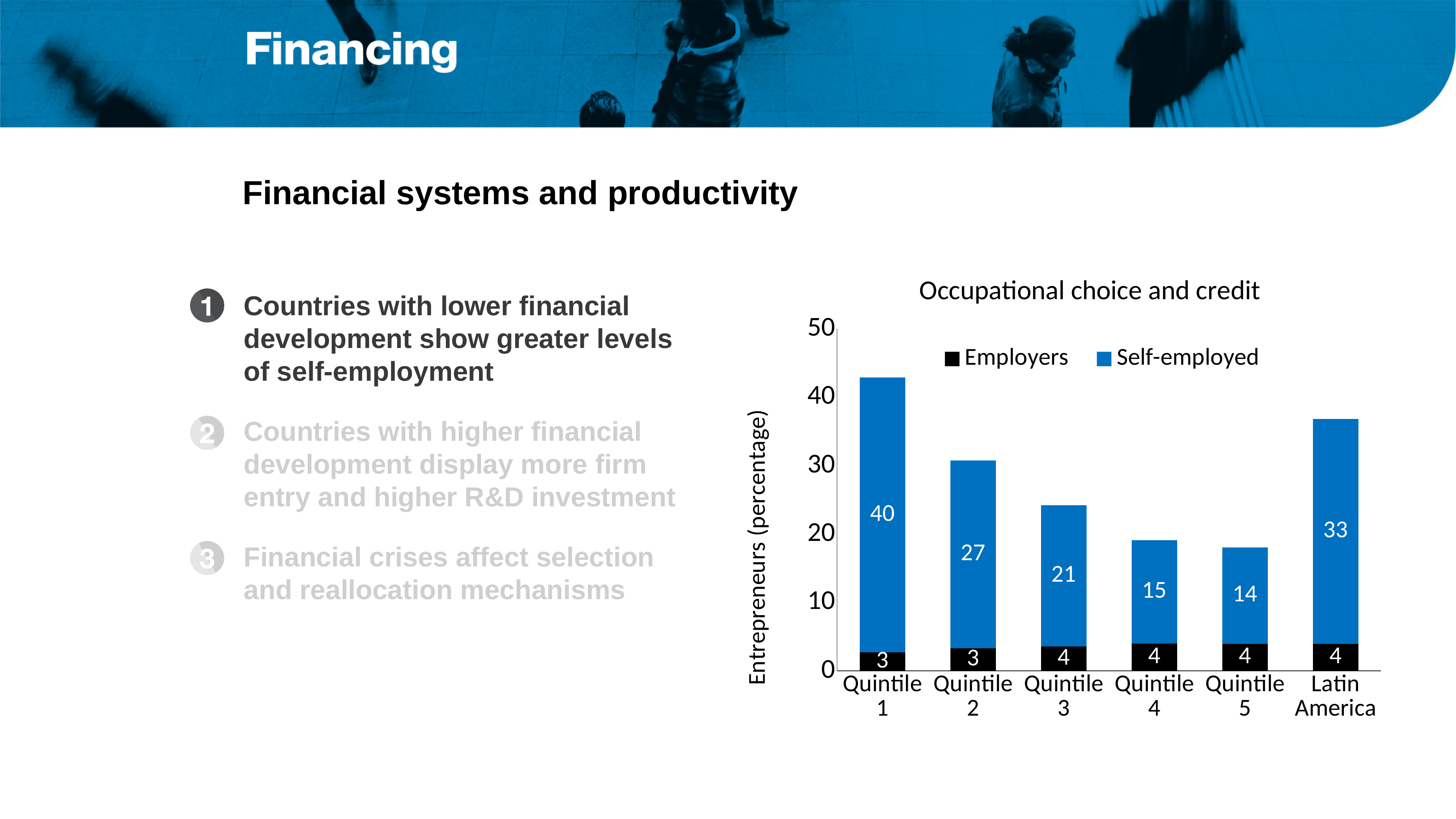
Which is larger, the Self-employed value for Quintile 3 or for Latin America? Latin America What kind of chart is shown? Stacked bar chart What is the total of the stacked bar for Quintile 1? 43 How many series does the legend list? 2 What is the Employers value for Latin America? 4 How many categories are shown on the x axis? 6 What is the difference between the Self-employed values for Quintile 1 and Quintile 2? 13 What is the Self-employed value for Quintile 4? 15 Which category has the highest Self-employed value? Quintile 1 What is the Self-employed value for Quintile 1? 40 Which category has the lowest Self-employed value? Quintile 5 What is the total of the stacked bar for Latin America? 37